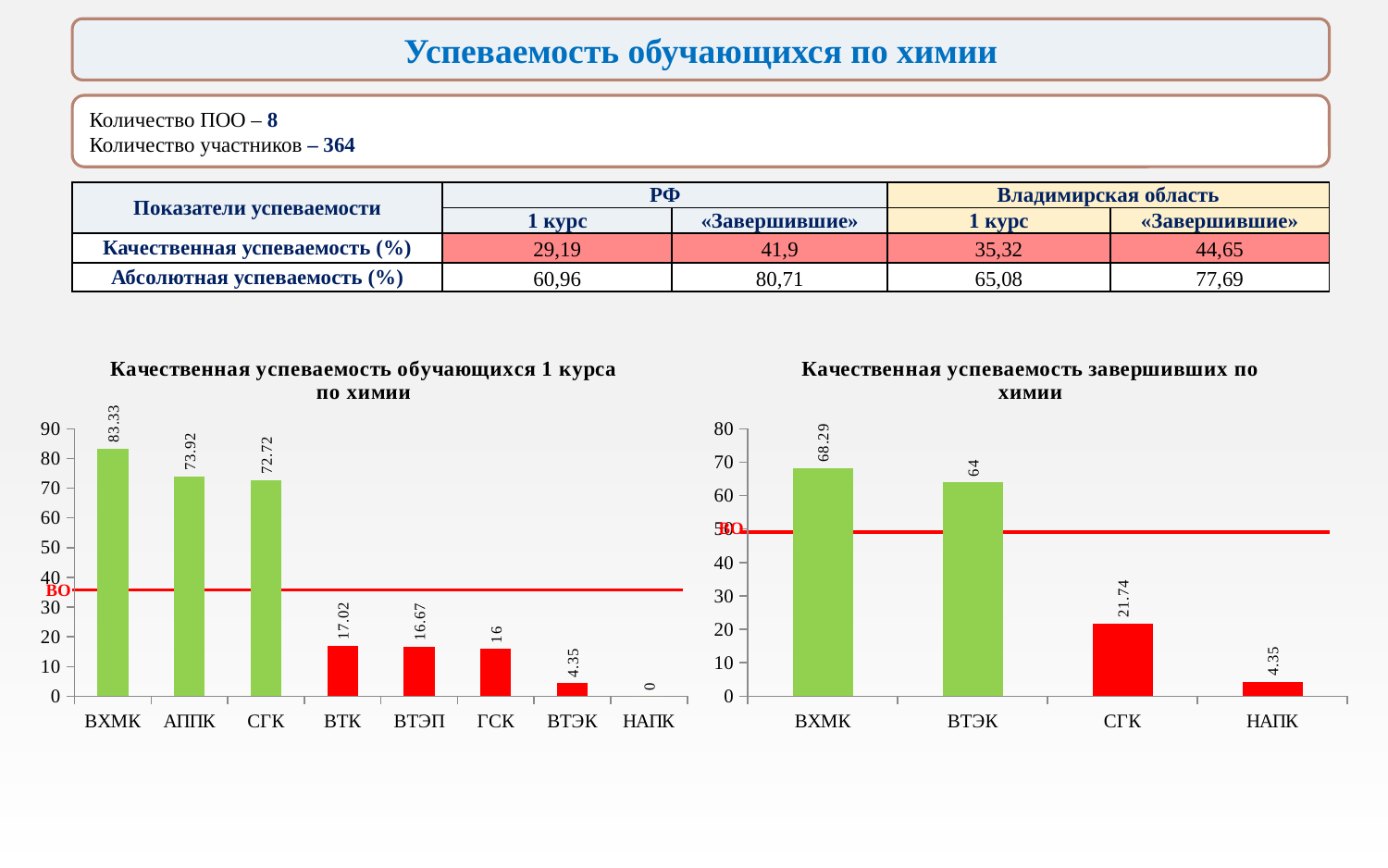
In the chart 'Качественная успеваемость завершивших по химии', what is the value for СГК? 21.74 In the chart 'Качественная успеваемость обучающихся 1 курса по химии', what is the value for ВТЭП? 16.67 In the chart 'Качественная успеваемость обучающихся 1 курса по химии', what is the difference between the values for АППК and СГК? 1.2 What type of chart is 'Качественная успеваемость завершивших по химии'? Bar chart In the chart 'Качественная успеваемость обучающихся 1 курса по химии', how many categories are shown on the x axis? 8 In the chart 'Качественная успеваемость завершивших по химии', how many categories are shown? 4 In the chart 'Качественная успеваемость обучающихся 1 курса по химии', which category has the highest value? ВХМК In the chart 'Качественная успеваемость завершивших по химии', what is the value for ВТЭК? 64 In the chart 'Качественная успеваемость обучающихся 1 курса по химии', which is larger, the value for ВТК or the value for ГСК? ВТК In the chart 'Качественная успеваемость обучающихся 1 курса по химии', what is the value for ВХМК? 83.33 In the chart 'Качественная успеваемость обучающихся 1 курса по химии', which category has the lowest value? НАПК In the chart 'Качественная успеваемость завершивших по химии', what is the difference between the values for ВХМК and ВТЭК? 4.29